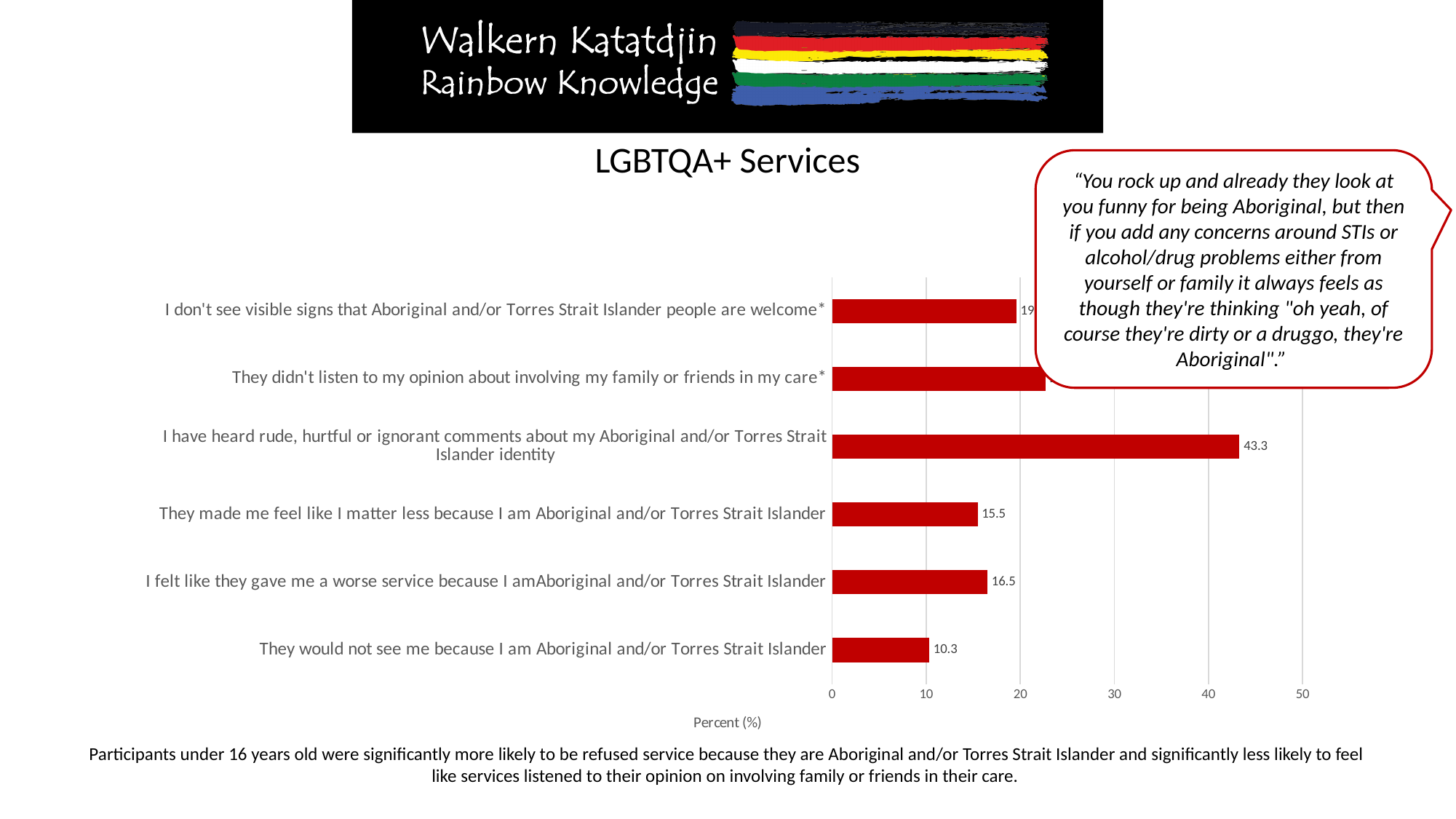
Which category has the lowest value? They would not see me because I am Aboriginal and/or Torres Strait Islander What is the value for "They made me feel like I matter less because I am Aboriginal and/or Torres Strait Islander"? 15.5 What is the value for "I have heard rude, hurtful or ignorant comments about my Aboriginal and/or Torres Strait Islander identity"? 43.3 Which is larger: the value for "I felt like they gave me a worse service because I am Aboriginal and/or Torres Strait Islander" or the value for "They made me feel like I matter less because I am Aboriginal and/or Torres Strait Islander"? I felt like they gave me a worse service because I am Aboriginal and/or Torres Strait Islander What is the difference between the value for "I have heard rude, hurtful or ignorant comments about my Aboriginal and/or Torres Strait Islander identity" and the value for "They would not see me because I am Aboriginal and/or Torres Strait Islander"? 33.0 What is the value for "I felt like they gave me a worse service because I am Aboriginal and/or Torres Strait Islander"? 16.5 What is the title of the chart? LGBTQA+ Services Is the value for "They didn't listen to my opinion about involving my family or friends in my care*" greater or less than 20? greater How many categories are shown in the chart? 6 Which category has the highest value? I have heard rude, hurtful or ignorant comments about my Aboriginal and/or Torres Strait Islander identity What is the value for "They would not see me because I am Aboriginal and/or Torres Strait Islander"? 10.3 What type of chart is shown on the slide? bar chart